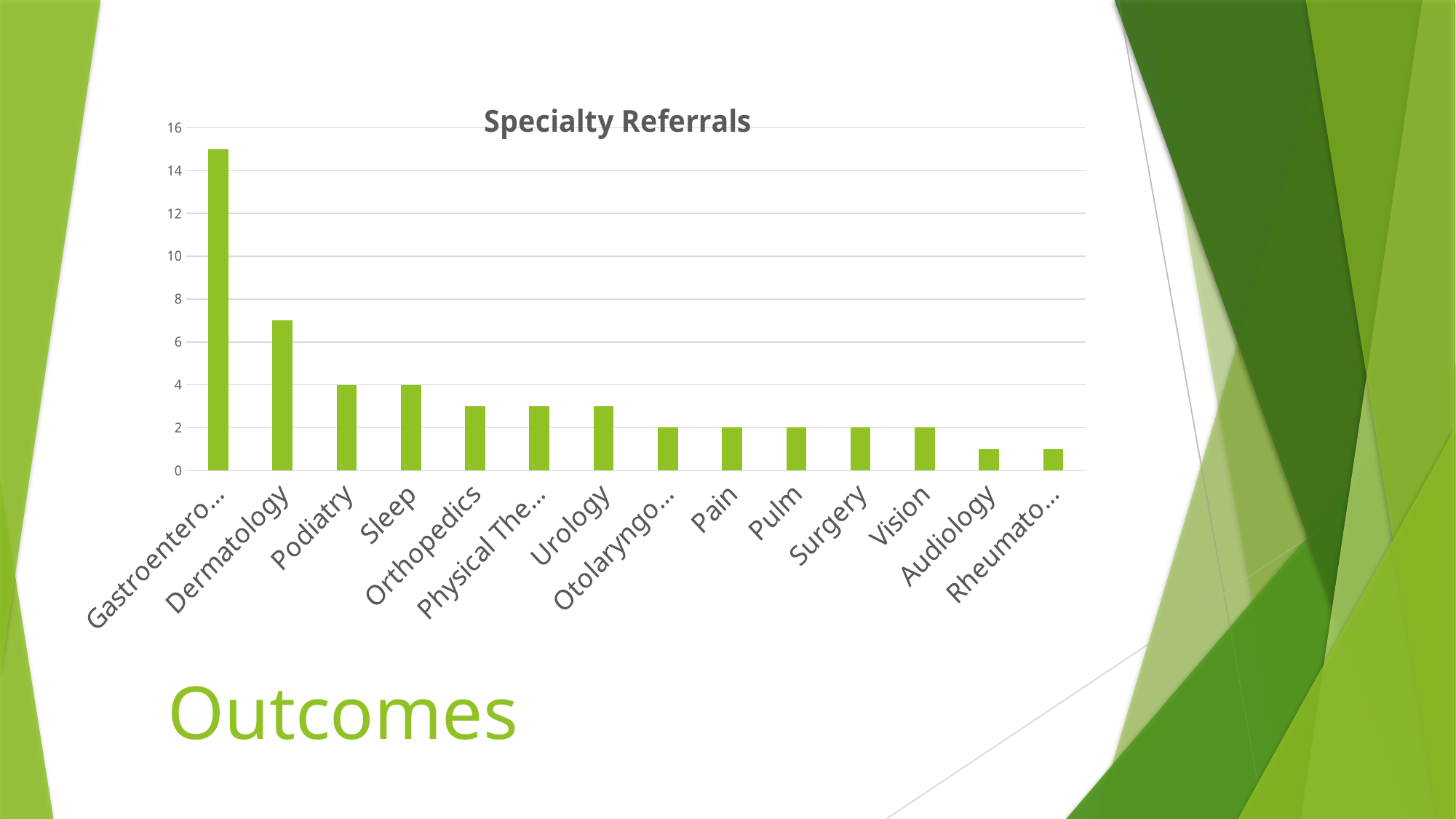
What is the title of the chart? Specialty Referrals How many categories are shown on the x axis of the chart? 14 Is the value for Dermatology greater or less than 6? greater Do the values generally rise or fall from left to right along the x axis? fall Is the value for Audiology greater or less than 2? less What is the value for Sleep? 4 Which has a larger value, Dermatology or Podiatry? Dermatology What is the value for Vision? 2 Is the value for Orthopedics greater or less than 4? less What is the value for Pain? 2 What is the value for Podiatry? 4 What type of chart is shown on the slide? bar chart